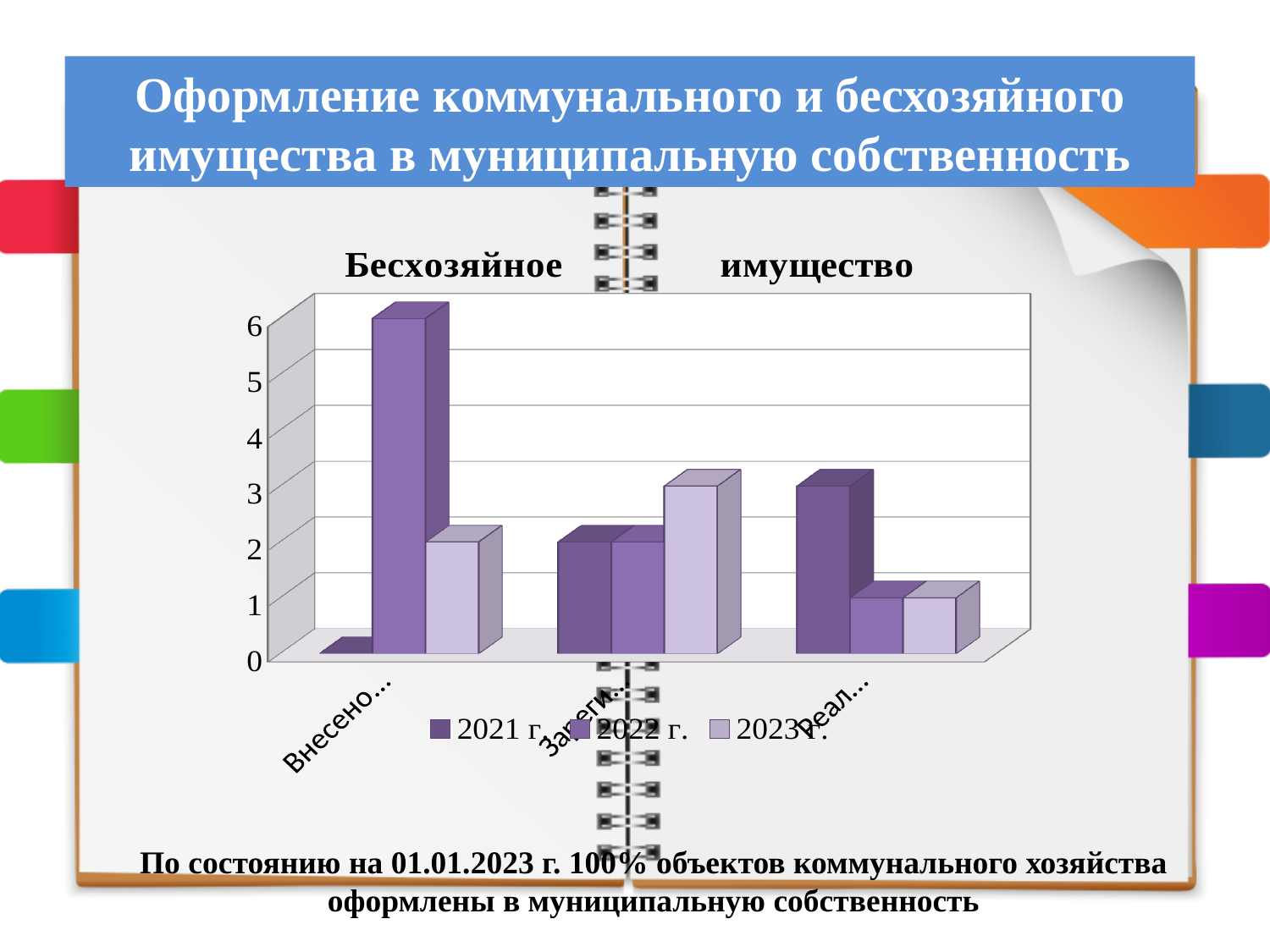
What kind of chart is shown on the slide? bar chart In the rightmost category of the chart, which is larger: the bar for 2021 г. or the bar for 2022 г.? 2021 г. Is the value for 2022 г. in the leftmost category greater or less than 5? greater Is the value for 2023 г. in the middle category greater or less than 2? greater How many series does the legend of the chart list? 3 Is the value for 2021 г. in the rightmost category greater or less than 2? greater Which years are listed in the chart's legend? 2021 г., 2022 г., 2023 г. How many categories are shown along the x axis of the chart? 3 In the leftmost category of the chart, which series has the lowest bar? 2021 г. In the leftmost category of the chart, which series has the highest bar? 2022 г. What is the title of the chart? Бесхозяйное имущество